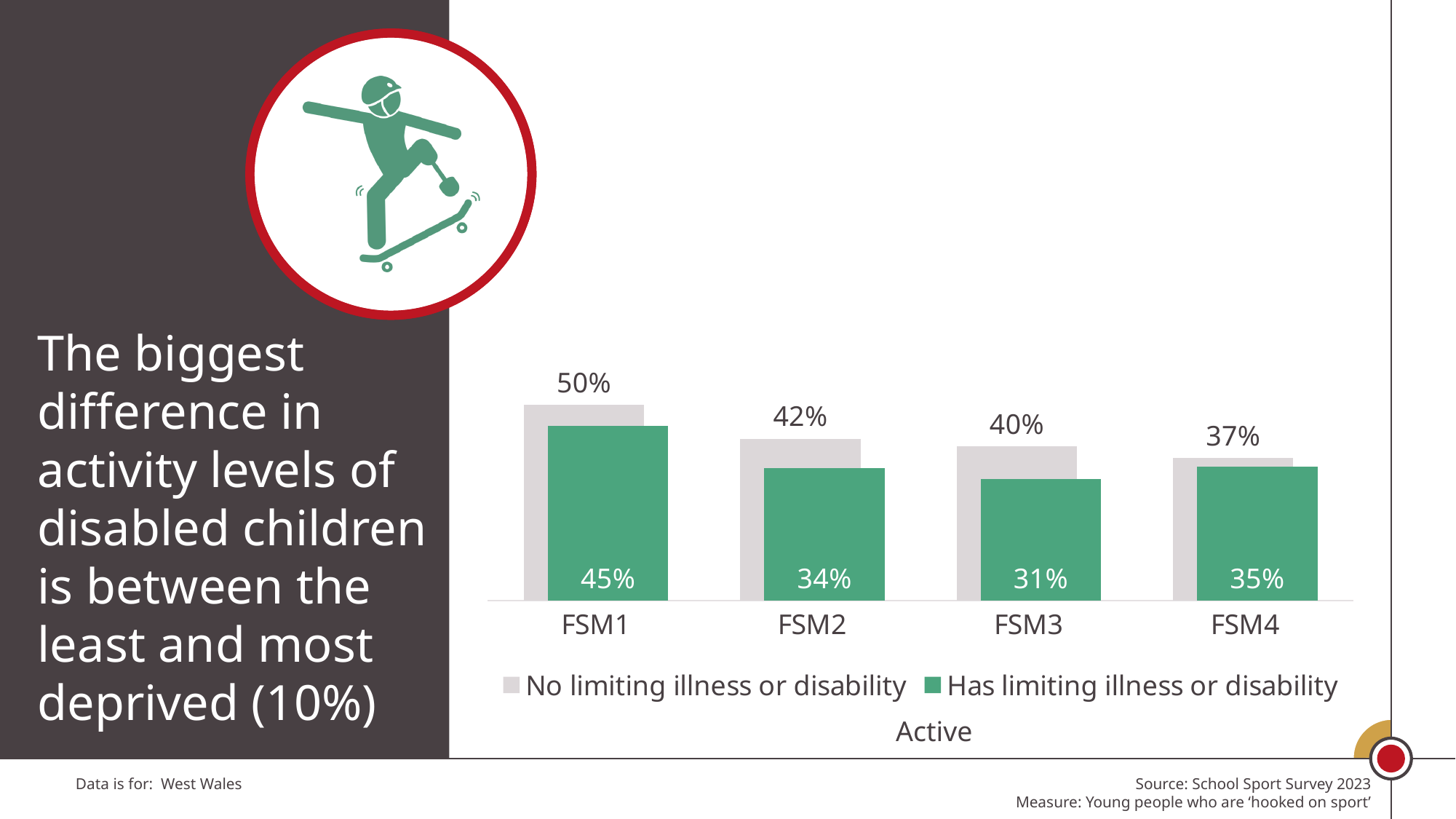
What kind of chart is shown on the slide? Bar chart How many series does the legend list? 2 What is the difference between the FSM1 and FSM4 values in the 'No limiting illness or disability' series? 13% What is the value for FSM1 in the 'No limiting illness or disability' series? 50% Which category has the highest value in the 'No limiting illness or disability' series? FSM1 Do the values in the 'No limiting illness or disability' series rise or fall from FSM1 to FSM4? Fall What is the value for FSM4 in the 'Has limiting illness or disability' series? 35% Which category has the lowest value in the 'Has limiting illness or disability' series? FSM3 What is the difference between the 'No limiting illness or disability' and 'Has limiting illness or disability' values for FSM2? 8% What is the value for FSM3 in the 'Has limiting illness or disability' series? 31% How many categories are shown on the x axis? 4 Which is larger for FSM4: the 'No limiting illness or disability' value or the 'Has limiting illness or disability' value? No limiting illness or disability